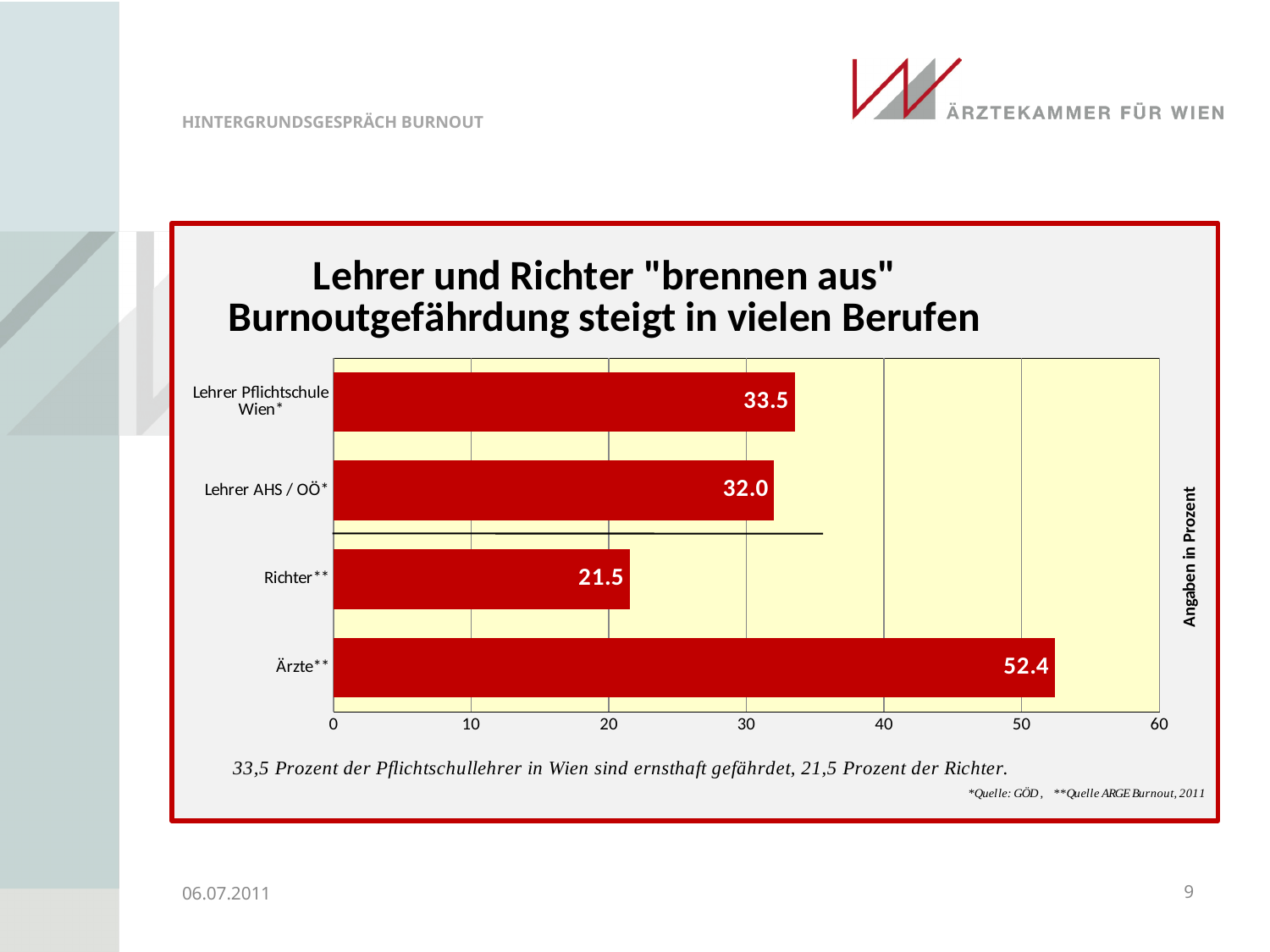
Which category has the lowest value? Richter** What is the value for Lehrer Pflichtschule Wien*? 33.5 How many categories are shown in the chart? 4 Which is larger, the value for Lehrer Pflichtschule Wien* or Lehrer AHS / OÖ*? Lehrer Pflichtschule Wien* What is the difference between the values for Ärzte** and Richter**? 30.9 Which category has the highest value? Ärzte** What is the value for Richter**? 21.5 What kind of chart is shown on the slide? bar chart What is the value for Lehrer AHS / OÖ*? 32.0 Is the value for Ärzte** greater or less than 50? greater What is the label on the vertical axis at the right of the chart? Angaben in Prozent What is the value for Ärzte**? 52.4